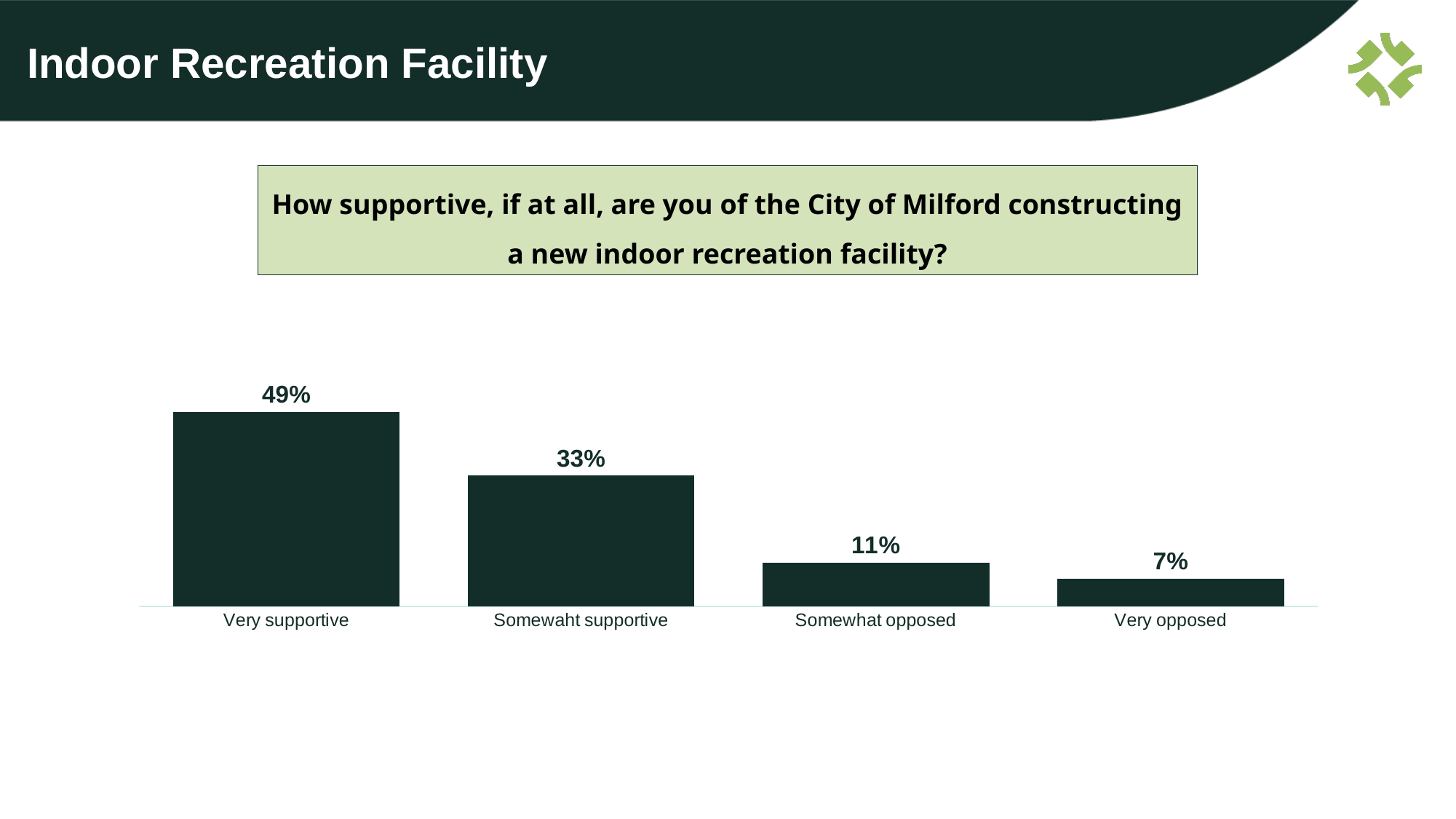
What is the difference in percentage points between very supportive and somewhat supportive? 16 What percentage of respondents are somewhat supportive? 33% What percentage of respondents are very opposed? 7% Which is larger, the percentage somewhat supportive or the percentage somewhat opposed? Somewhat supportive How many response categories are shown in the chart? 4 What percentage of respondents are somewhat opposed? 11% Which response category has the lowest percentage? Very opposed Which response category has the highest percentage? Very supportive What is the difference in percentage points between somewhat opposed and very opposed? 4 What percentage of respondents are very supportive of constructing a new indoor recreation facility? 49% Do the values rise or fall from left to right across the categories? Fall What kind of chart is shown on the slide? Bar chart